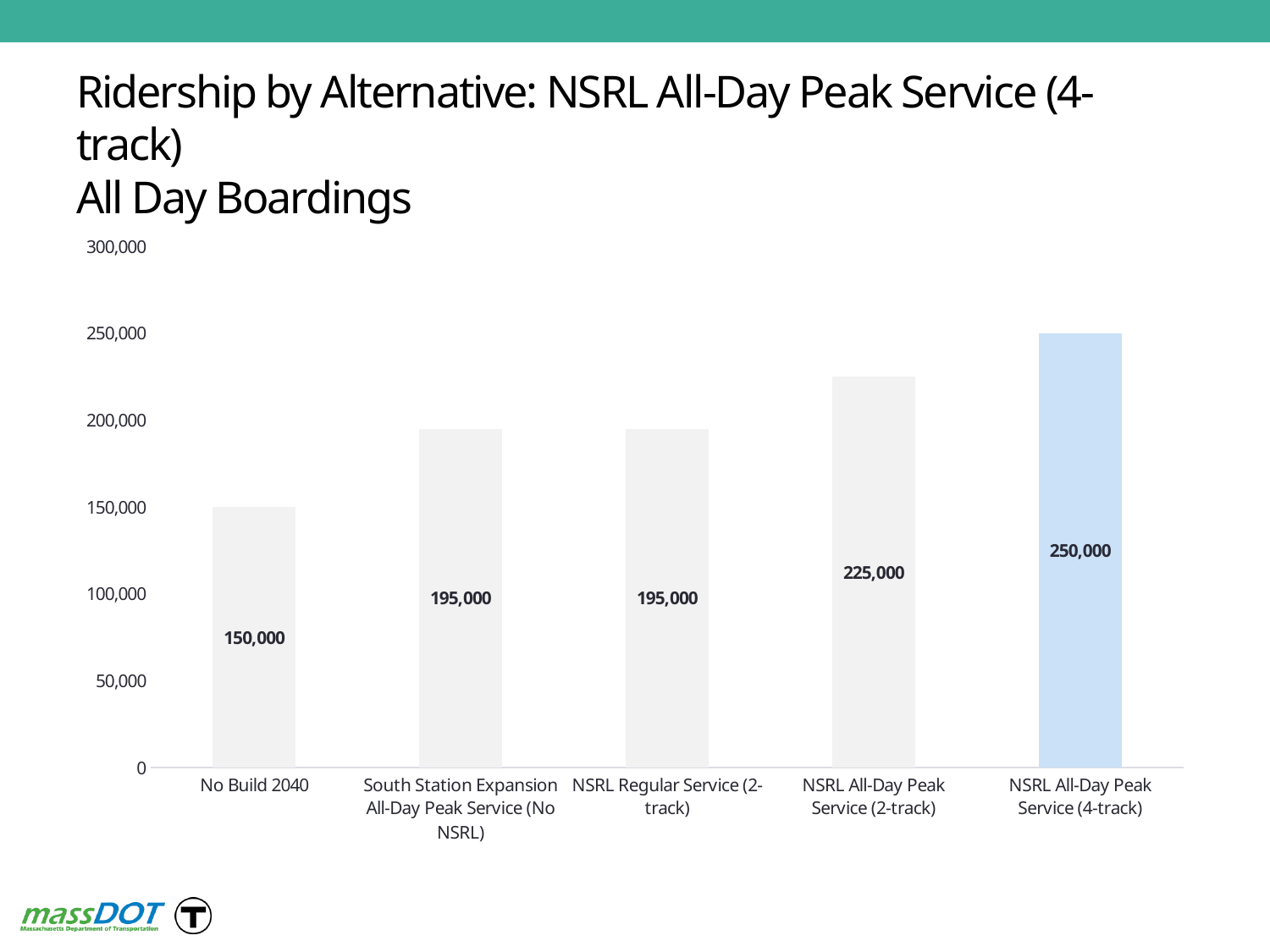
Which alternative has the highest all day boardings? NSRL All-Day Peak Service (4-track) Which alternative has the lowest all day boardings? No Build 2040 Is the value for NSRL Regular Service (2-track) greater or less than 200,000? less What is the value for NSRL All-Day Peak Service (2-track)? 225,000 Which bar is highlighted in a different colour (light blue) from the others? NSRL All-Day Peak Service (4-track) How many alternatives are shown on the chart? 5 What is the value for NSRL All-Day Peak Service (4-track)? 250,000 What kind of chart is shown on the slide? bar chart What is the difference between NSRL All-Day Peak Service (4-track) and No Build 2040? 100,000 What is the value for No Build 2040? 150,000 Which is larger, NSRL All-Day Peak Service (2-track) or South Station Expansion All-Day Peak Service (No NSRL)? NSRL All-Day Peak Service (2-track) What is the difference between NSRL All-Day Peak Service (2-track) and NSRL Regular Service (2-track)? 30,000